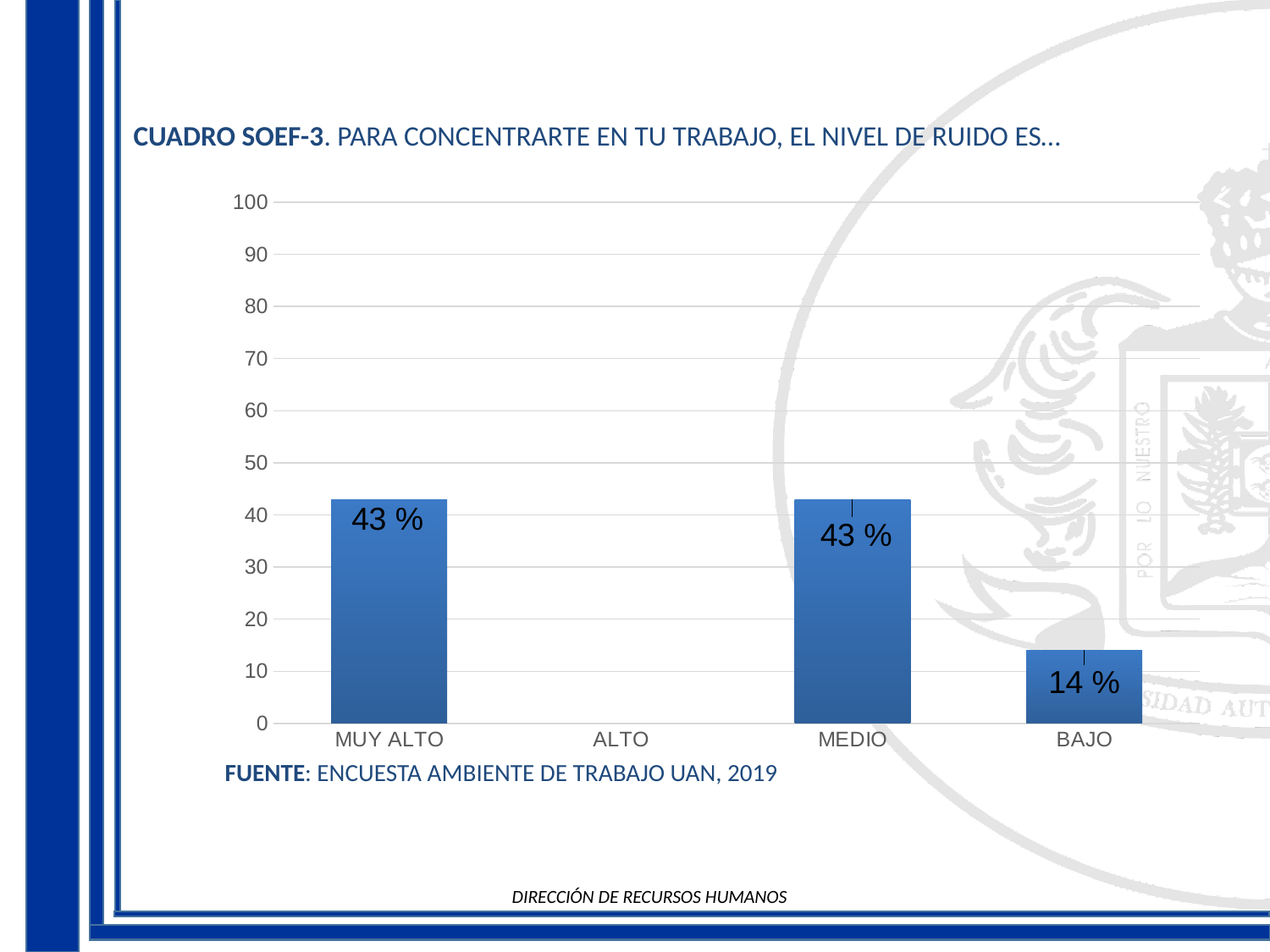
What kind of chart is shown on the slide? Bar chart What is the value shown for MUY ALTO? 43 % Which of the bars with a printed value is the lowest? BAJO What is the title of the chart? CUADRO SOEF-3. PARA CONCENTRARTE EN TU TRABAJO, EL NIVEL DE RUIDO ES… Is the value for MUY ALTO greater or less than 50? less What is the value shown for MEDIO? 43 % What is the value shown for BAJO? 14 % What source is cited below the chart? ENCUESTA AMBIENTE DE TRABAJO UAN, 2019 What is the difference between the values for MEDIO and BAJO? 29 % Is the value for BAJO greater or less than 20? less How many categories are labelled on the x axis? 4 Which is larger, the value for MEDIO or the value for BAJO? MEDIO